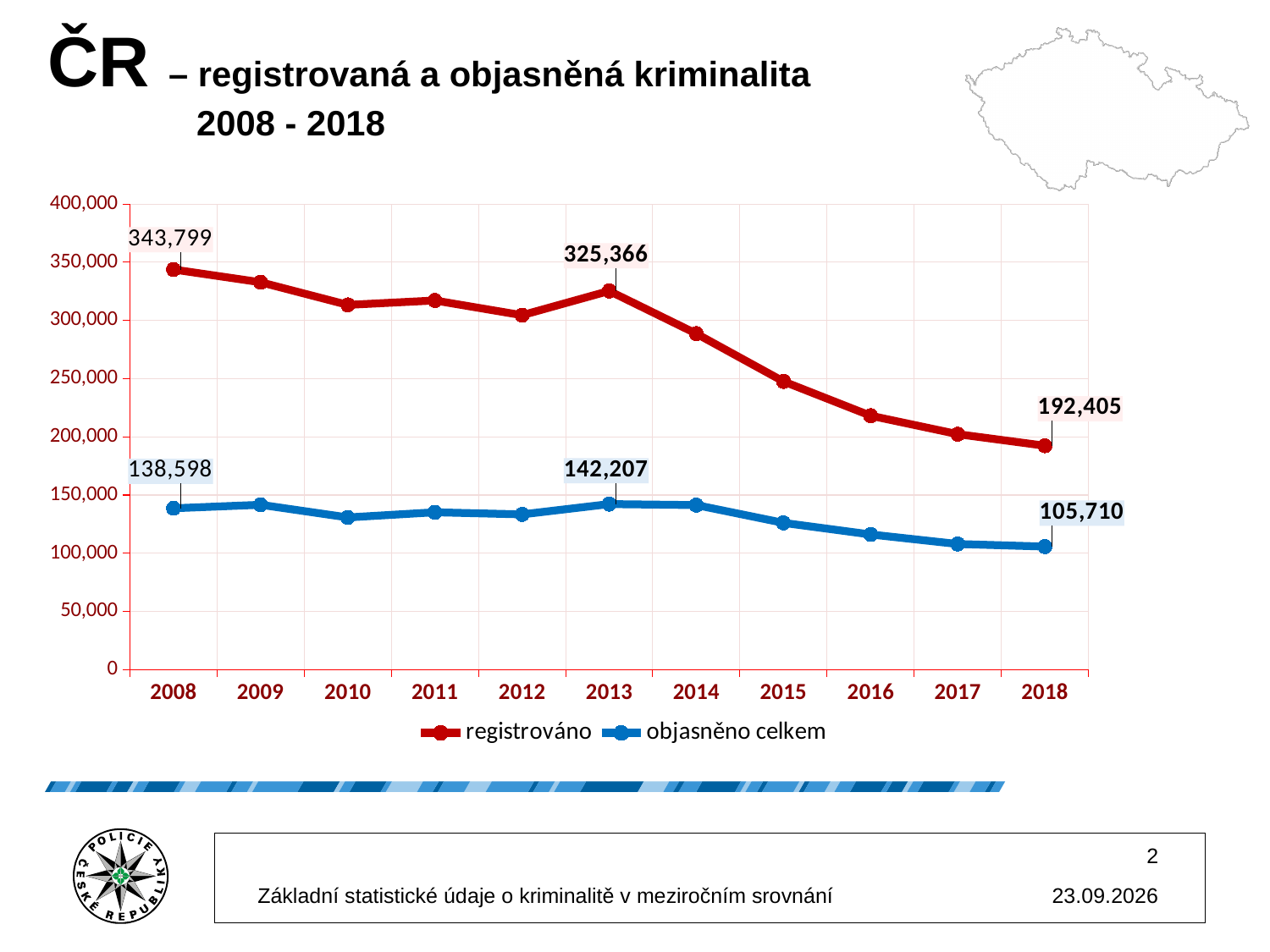
What is the value for registrováno in 2018? 192,405 What is the difference between registrováno and objasněno celkem in 2013? 183,159 How many series does the legend list? 2 What type of chart is shown on the slide? line chart What is the value for objasněno celkem in 2018? 105,710 What is the value for objasněno celkem in 2008? 138,598 Does the registrováno series rise or fall from 2013 to 2018? fall What is the value for registrováno in 2008? 343,799 What is the difference between the registrováno values for 2008 and 2018? 151,394 How many years are shown on the x axis? 11 What is the value for registrováno in 2013? 325,366 Is the value for registrováno in 2015 greater or less than 200,000? greater